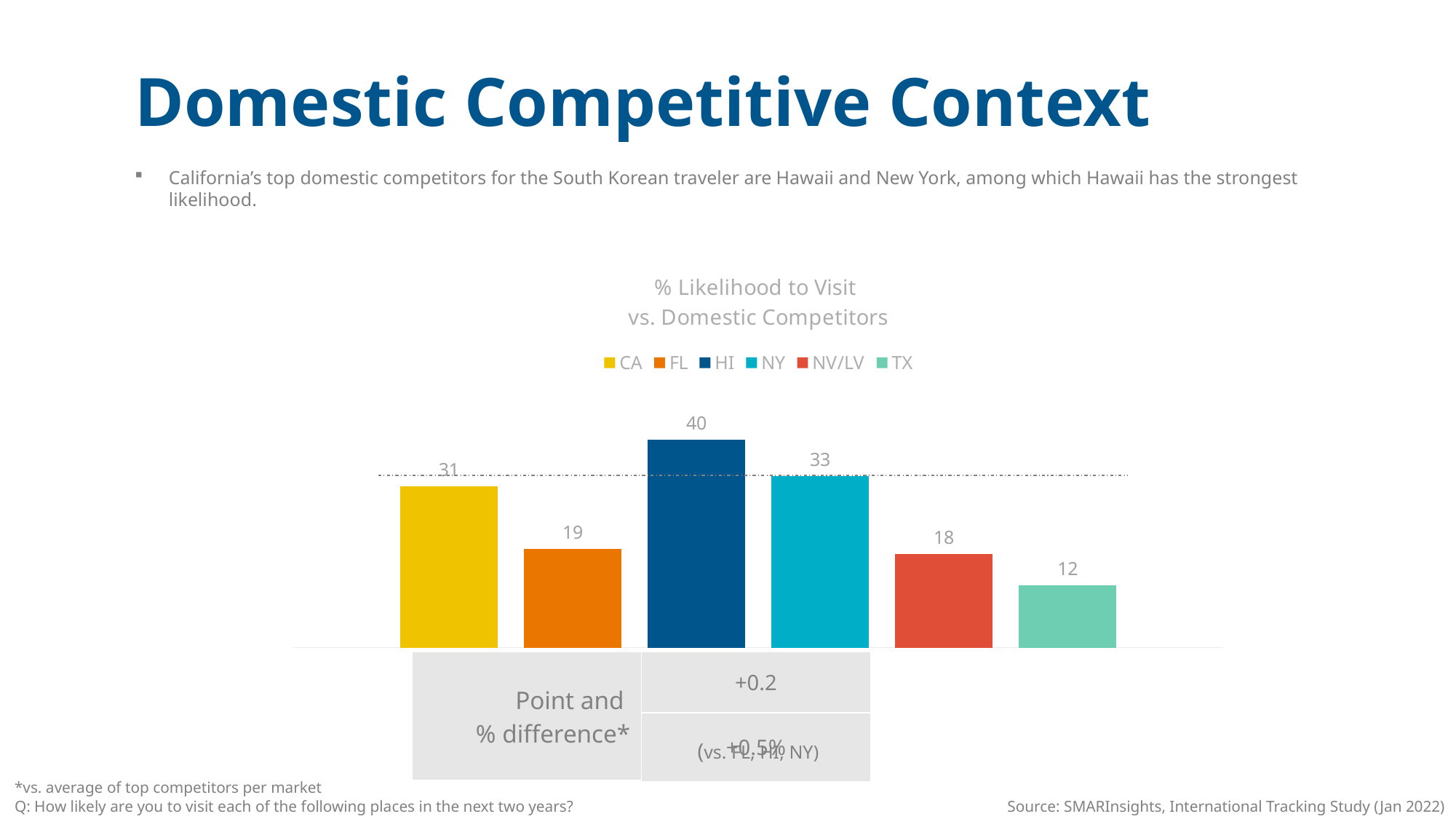
Which state has the lowest % likelihood to visit? TX Which has a higher value, FL or NV/LV? FL What type of chart is shown on the slide? Bar chart What is the difference between the values for HI and CA? 9 How many series does the legend list? 6 What is the % likelihood to visit value for HI? 40 How many bars are shown in the chart? 6 What is the difference between the values for NY and FL? 14 What is the % likelihood to visit value for CA? 31 Which state has the highest % likelihood to visit? HI What is the value shown for TX? 12 Which has a higher value, NY or CA? NY